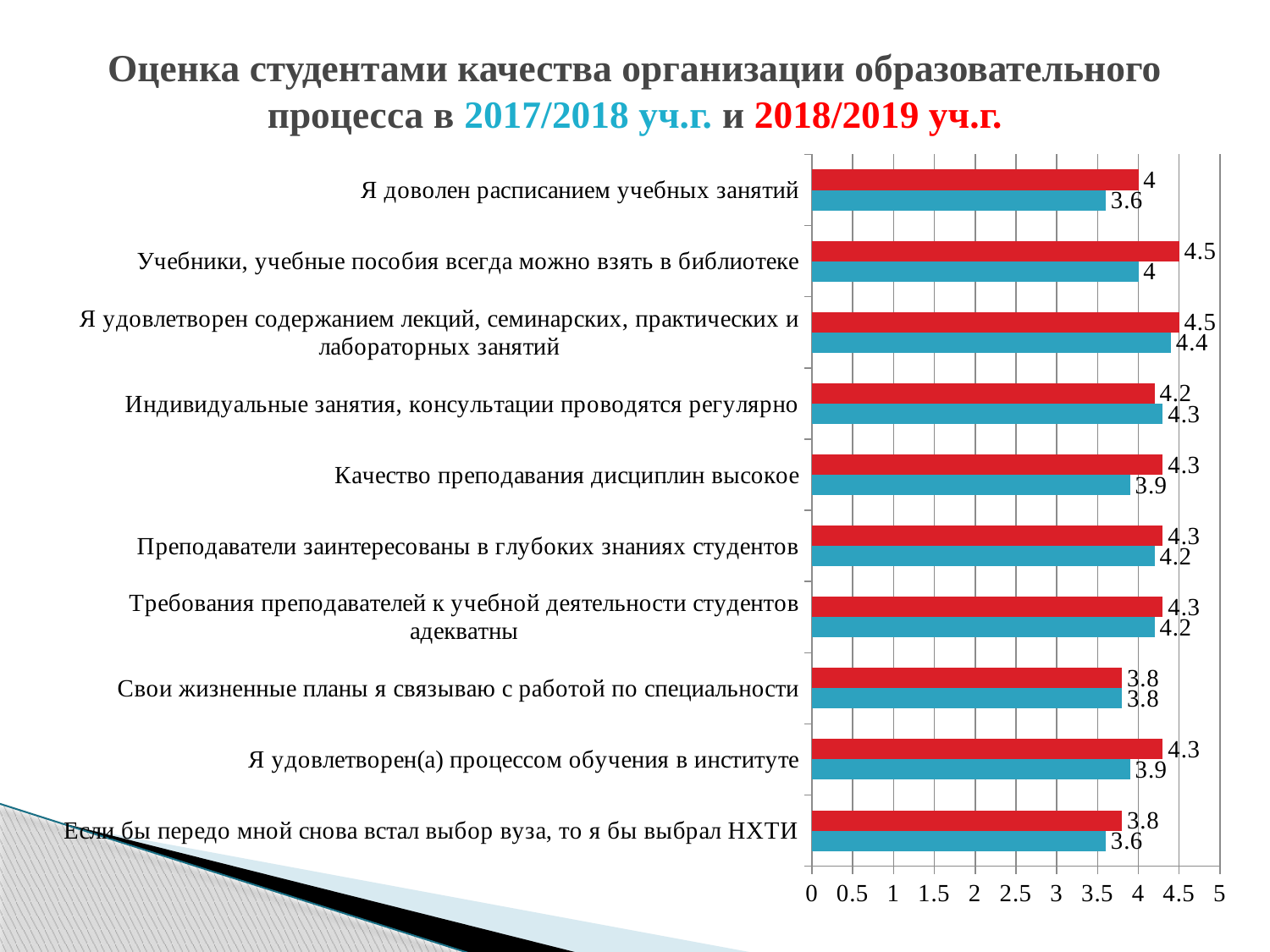
What is the value of the blue bar for "Я доволен расписанием учебных занятий"? 3.6 What is the maximum value shown on the horizontal axis of the chart? 5 How many categories (statements) are plotted in the chart? 10 What is the difference between the red and blue bars for "Качество преподавания дисциплин высокое"? 0.4 For "Индивидуальные занятия, консультации проводятся регулярно", which bar is larger, the red or the blue? blue What is the value of the blue bar for "Если бы передо мной снова встал выбор вуза, то я бы выбрал НХТИ"? 3.6 What is the value of the blue bar for "Учебники, учебные пособия всегда можно взять в библиотеке"? 4 What is the difference between the red and blue bars for "Учебники, учебные пособия всегда можно взять в библиотеке"? 0.5 What is the value of the red bar for "Качество преподавания дисциплин высокое"? 4.3 Which statement has the lowest red bar value? Свои жизненные планы я связываю с работой по специальности and Если бы передо мной снова встал выбор вуза, то я бы выбрал НХТИ (both 3.8) What is the value of the red bar for "Я доволен расписанием учебных занятий"? 4 What type of chart is shown on the slide? bar chart